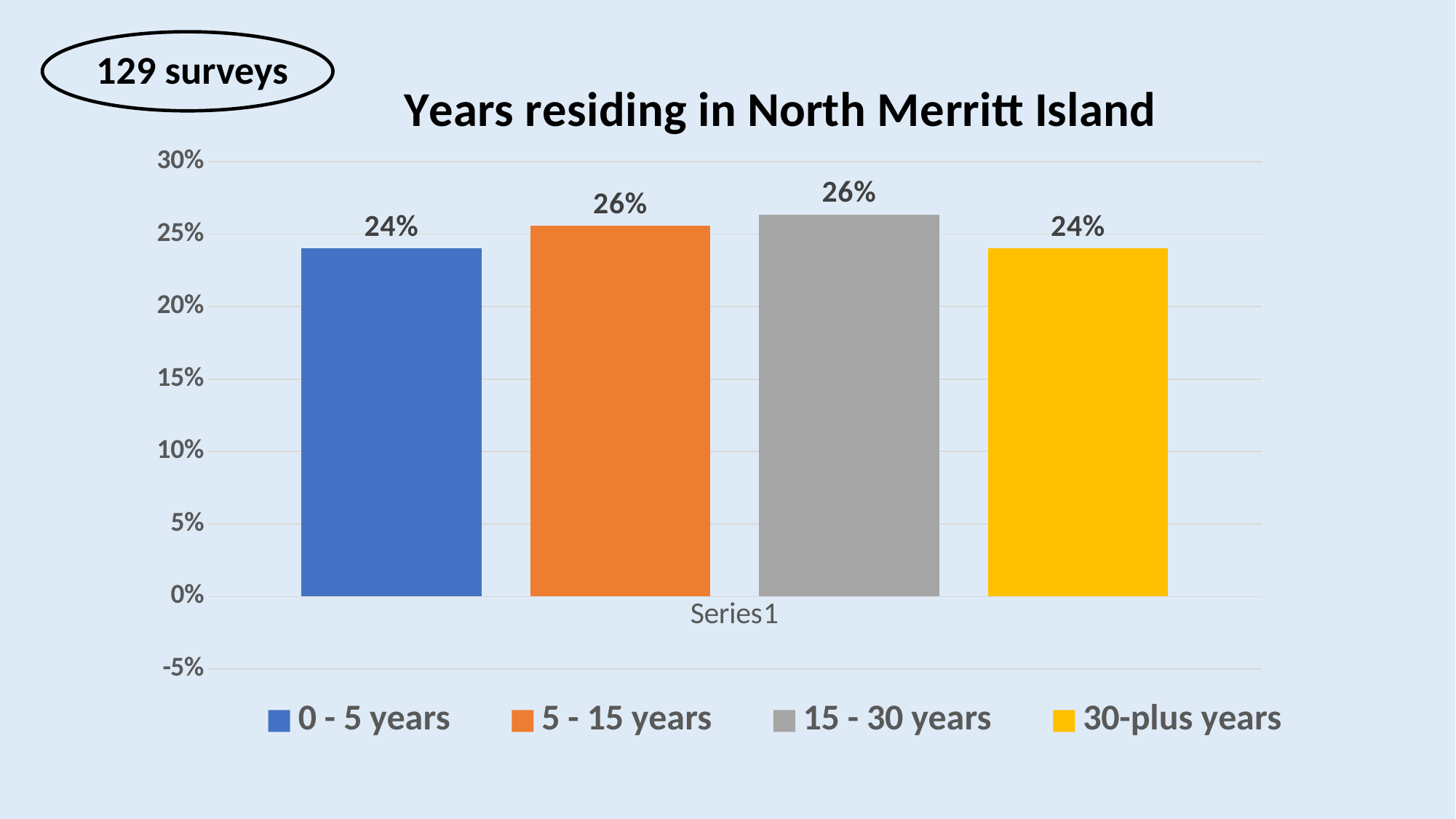
Which is larger, the value for 5 - 15 years or the value for 30-plus years? 5 - 15 years How many entries does the legend list? 4 What is the title of the chart? Years residing in North Merritt Island What kind of chart is shown on the slide? bar chart How many bars are plotted in the chart? 4 What is the value for 30-plus years? 24% Is the value for 0 - 5 years greater or less than 20%? greater What is the value for 5 - 15 years? 26% Is the value for 15 - 30 years greater or less than 30%? less What is the difference between the value for 15 - 30 years and the value for 0 - 5 years? 2% What is the value for 0 - 5 years? 24% What is the value for 15 - 30 years? 26%